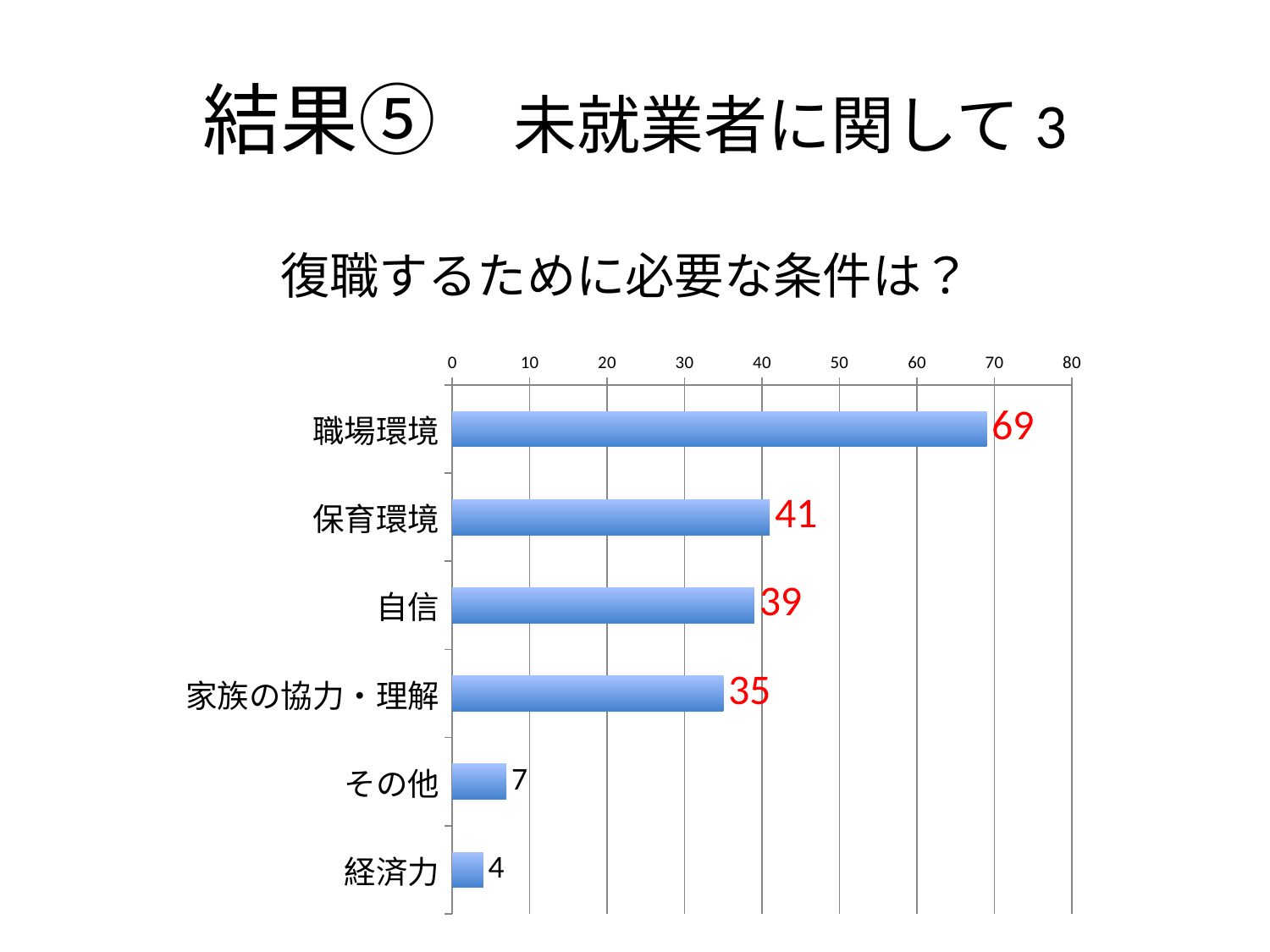
What is the value for 職場環境? 69 How many categories are shown in the chart? 6 What question is posed above the chart? 復職するために必要な条件は？ Which is larger, the value for 保育環境 or the value for 自信? 保育環境 What is the value for 保育環境? 41 What is the difference between the values for 職場環境 and 保育環境? 28 Which category has the lowest value? 経済力 Which category has the highest value? 職場環境 What is the difference between the values for 自信 and 家族の協力・理解? 4 What kind of chart is shown on the slide? Bar chart What is the value for 経済力? 4 What is the value for 家族の協力・理解? 35